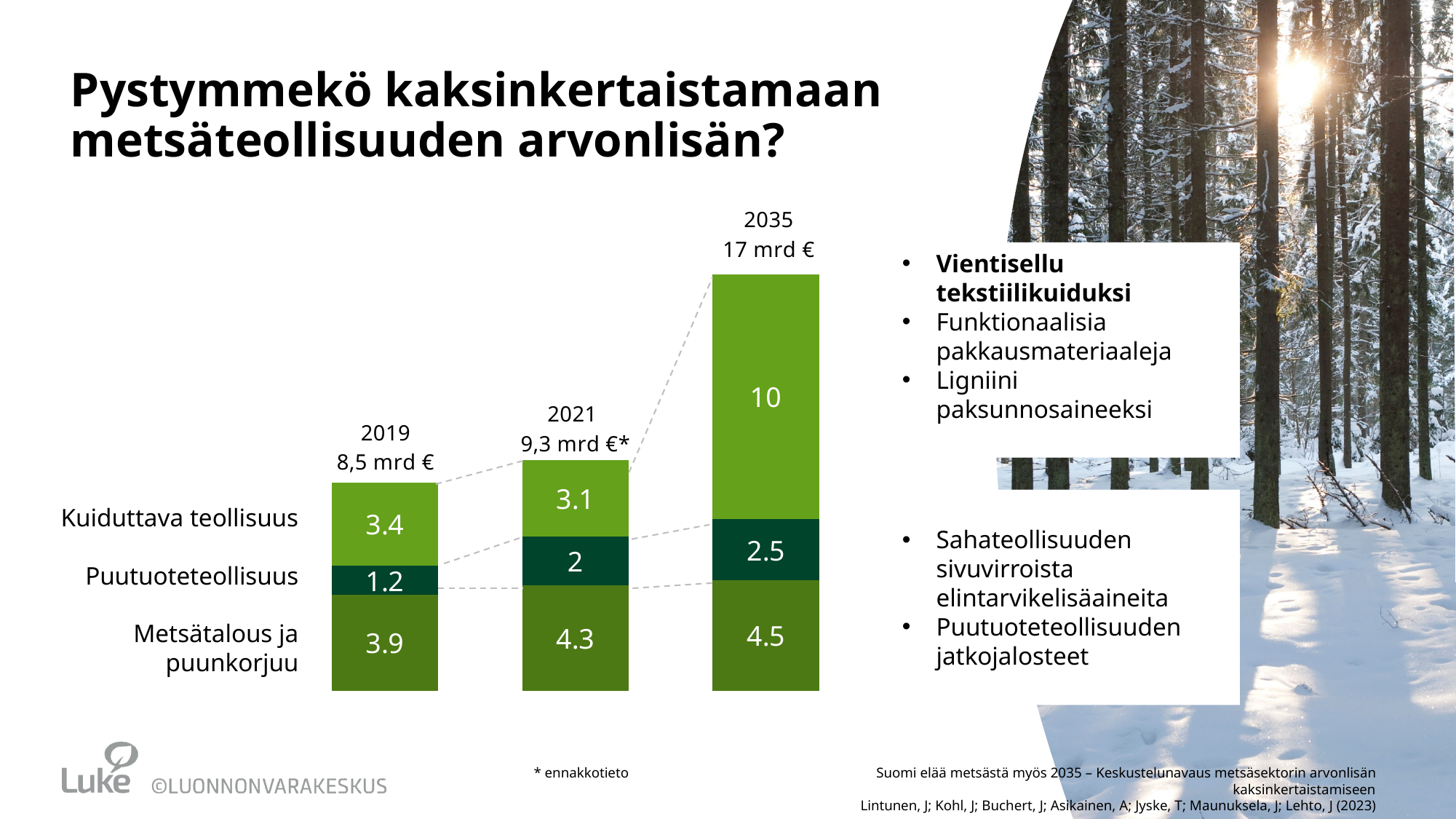
What total is printed above the 2035 bar? 17 mrd € How many segments (series) make up each stacked bar? 3 Which year has the highest value for Kuiduttava teollisuus? 2035 Which is larger: Kuiduttava teollisuus in 2019 or Kuiduttava teollisuus in 2021? Kuiduttava teollisuus in 2019 What total is printed above the 2019 bar? 8,5 mrd € What is the value for Puutuoteteollisuus in 2019? 1.2 What is the difference between the Metsätalous ja puunkorjuu values for 2035 and 2019? 0.6 Which year has the lowest value for Puutuoteteollisuus? 2019 What is the value for Kuiduttava teollisuus in 2035? 10 What kind of chart is shown on the slide? Stacked bar chart How many bars (years) are shown in the chart? 3 What is the value for Metsätalous ja puunkorjuu in 2021? 4.3